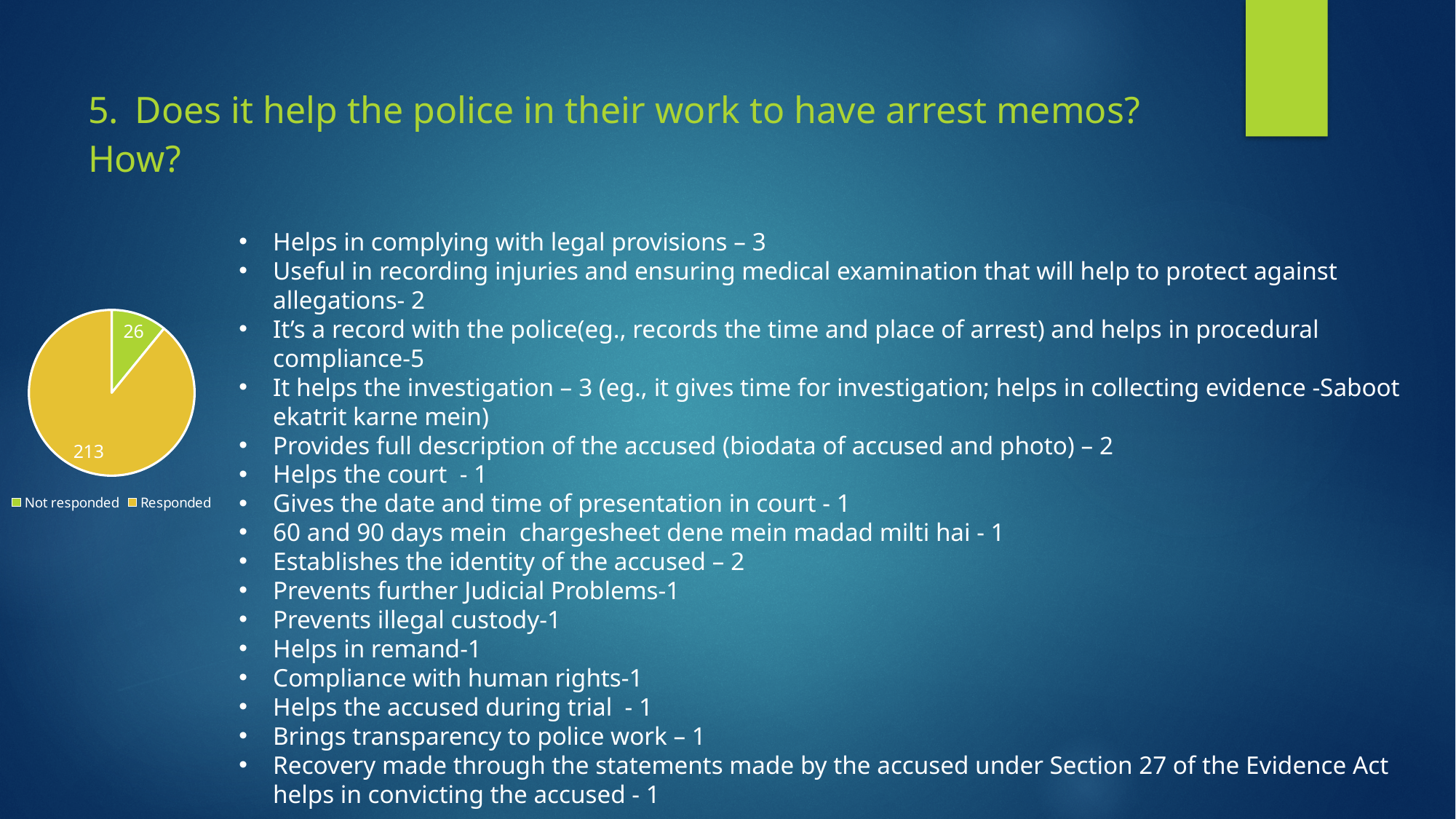
What colour is the Responded slice in the pie chart? yellow What kind of chart is shown on the slide? pie chart What is the value for the Responded slice of the pie chart? 213 Which is larger in the pie chart, Responded or Not responded? Responded What is the total of the two values shown in the pie chart? 239 What is the value for the Not responded slice of the pie chart? 26 Which slice of the pie chart is the largest? Responded How many entries does the pie chart's legend list? 2 Which slice of the pie chart is the smallest? Not responded What colour is the Not responded slice in the pie chart? green What is the difference between the Responded and Not responded values in the pie chart? 187 How many slices does the pie chart have? 2